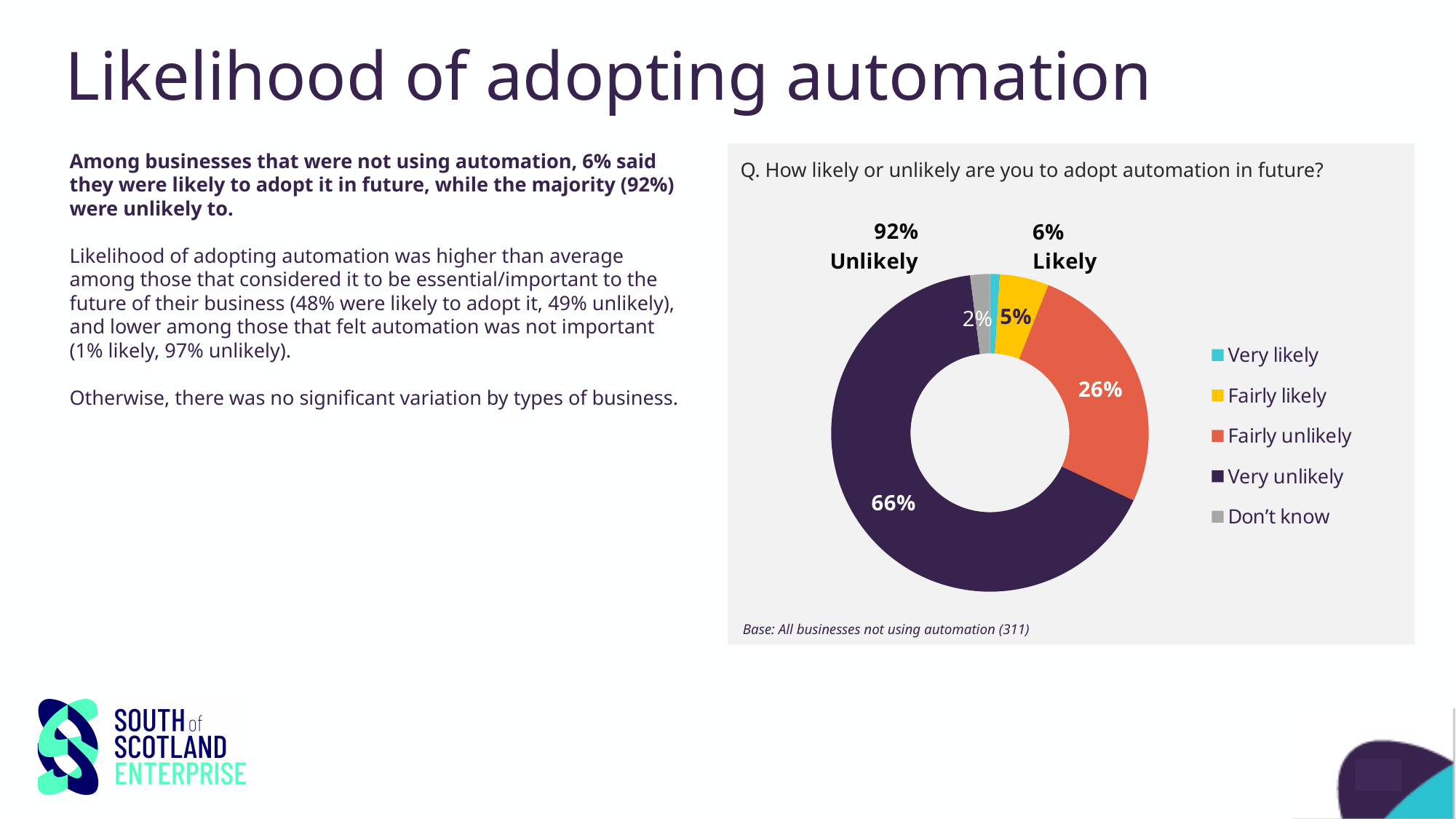
What percentage of businesses answered 'Don't know'? 2% What is the base size stated beneath the chart? All businesses not using automation (311) What is the difference in percentage points between 'Very unlikely' and 'Fairly unlikely'? 40 Which response category has the largest share of the chart? Very unlikely What percentage of businesses said they were 'Very unlikely' to adopt automation in future? 66% What percentage of businesses said they were 'Fairly unlikely' to adopt automation? 26% What type of chart is shown on the slide? Pie chart (donut) Which is larger, the share for 'Fairly likely' or the share for 'Fairly unlikely'? Fairly unlikely What is the combined percentage shown for the 'Unlikely' responses? 92% How many response categories does the legend list? 5 What is the combined percentage shown for the 'Likely' responses? 6% What percentage of businesses said they were 'Fairly likely' to adopt automation? 5%